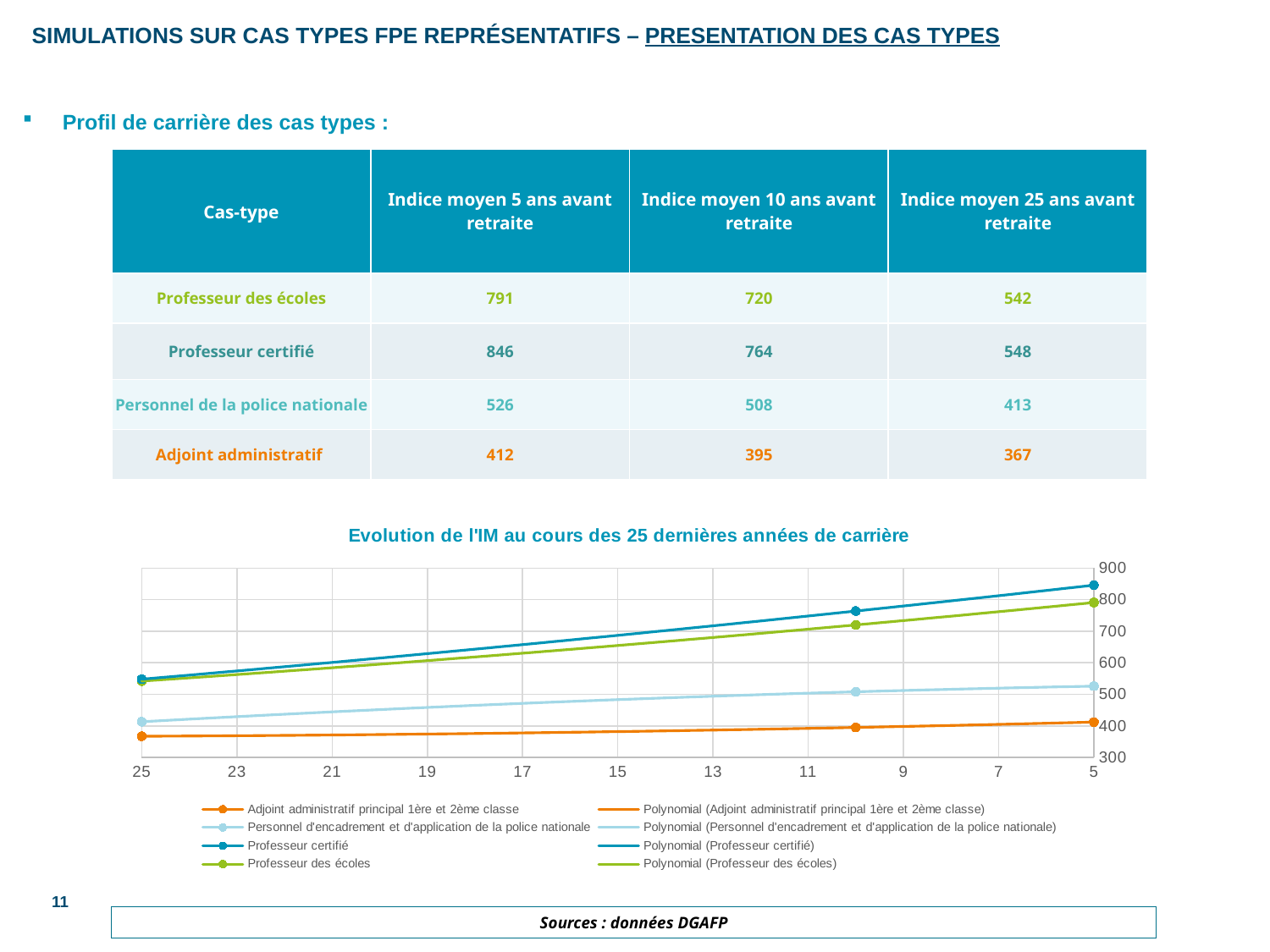
In the chart, is the value for Professeur certifié at 25 greater or less than 500? greater In the chart, is the value for Adjoint administratif principal 1ère et 2ème classe at 25 greater or less than 400? less In the chart, which series has the lowest value at 25 years before retirement? Adjoint administratif principal 1ère et 2ème classe How many entries does the legend of the chart list? 8 What kind of chart is shown under the title 'Evolution de l'IM au cours des 25 dernières années de carrière'? line chart In the chart, is the value for Professeur certifié at 5 greater or less than 800? greater In the chart, do the values for Professeur certifié rise or fall moving from 25 to 5 along the x axis? rise How many marked data points does each series in the chart have? 3 In the chart, which series has the highest value at 5 years before retirement? Professeur certifié In the chart, which is larger at 5: Professeur des écoles or Personnel d'encadrement et d'application de la police nationale? Professeur des écoles What is the title of the chart on the slide? Evolution de l'IM au cours des 25 dernières années de carrière